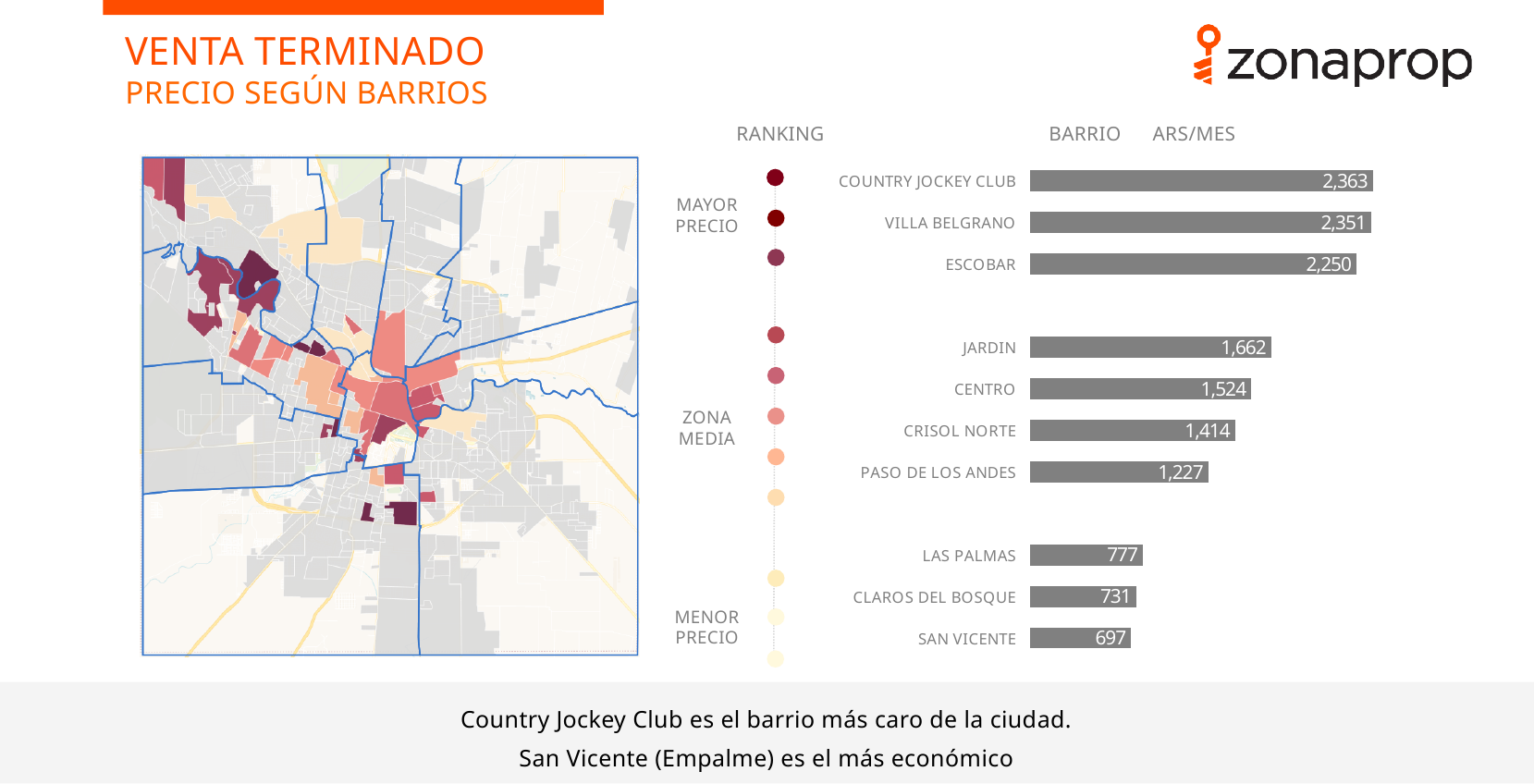
What is the ARS/MES value for Paso de los Andes? 1,227 Which barrio has the highest ARS/MES value? Country Jockey Club Which barrio has the lowest ARS/MES value? San Vicente What is the ARS/MES value for Country Jockey Club? 2,363 How many barrios are shown in the bar chart? 10 What is the ARS/MES value for Claros del Bosque? 731 What is the difference in ARS/MES between Country Jockey Club and Villa Belgrano? 12 What kind of chart is used to show the ARS/MES values by barrio? Bar chart What is the ARS/MES value for Escobar? 2,250 What is the column header above the bar values? ARS/MES Which has a higher ARS/MES value, Crisol Norte or Las Palmas? Crisol Norte What is the difference in ARS/MES between Jardin and Centro? 138